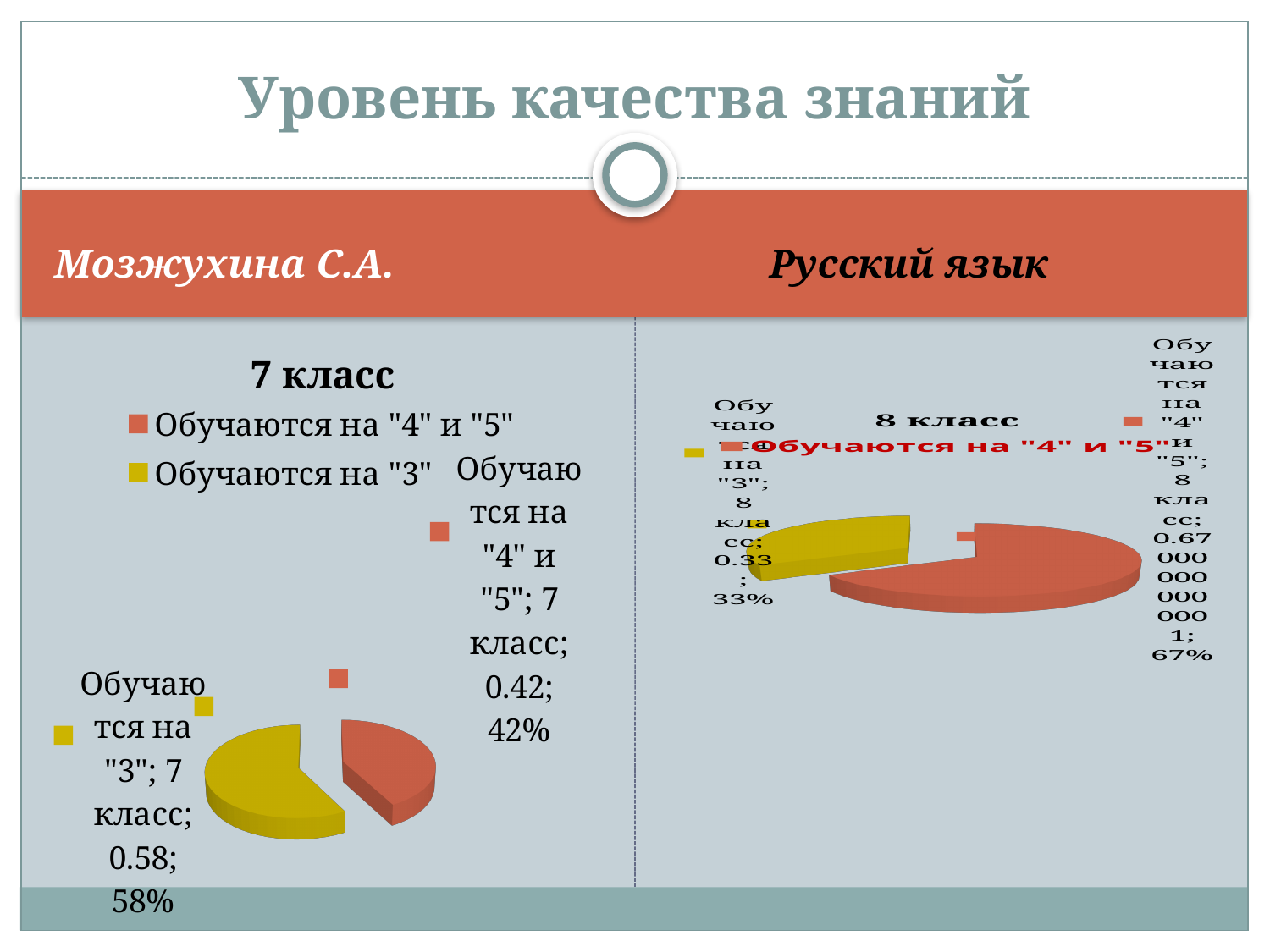
Which chart shows a larger share for "Обучаются на "4" и "5"": the "7 класс" chart or the "8 класс" chart? 8 класс In the "7 класс" chart, what percentage share is shown for "Обучаются на "4" и "5""? 42% In the "7 класс" chart, what percentage share is shown for "Обучаются на "3""? 58% In the "8 класс" chart, what percentage share is shown for "Обучаются на "4" и "5""? 67% In the "8 класс" chart, which category has the smaller slice? Обучаются на "3" In the "8 класс" chart, what is the difference in percentage points between the "Обучаются на "4" и "5"" slice and the "Обучаются на "3"" slice? 34% In the "7 класс" chart, which category has the larger slice? Обучаются на "3" In the "8 класс" chart, what percentage share is shown for "Обучаются на "3""? 33% In the "7 класс" chart, what colour is the slice for "Обучаются на "3""? yellow How many slices does the "7 класс" pie chart have? 2 In the "7 класс" chart, what is the difference in percentage points between the "Обучаются на "3"" slice and the "Обучаются на "4" и "5"" slice? 16% What kind of chart is the "7 класс" chart on the left? pie chart